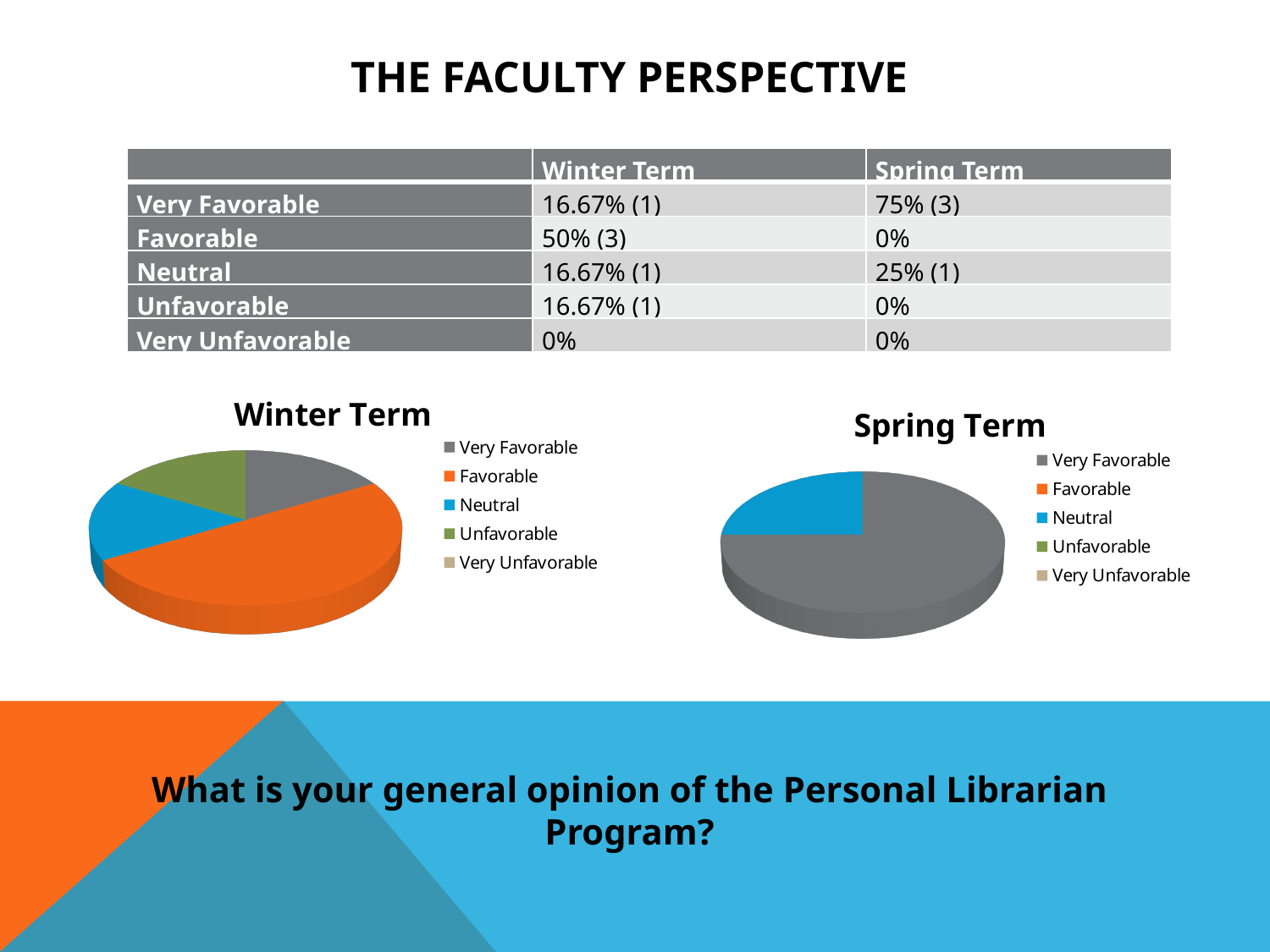
How many entries does the legend of the Spring Term chart list? 5 In the Spring Term chart, what share of the pie is Very Favorable? 75% In the Winter Term chart, what share of the pie is Favorable? 50% In the Spring Term chart, which category has the largest slice? Very Favorable What kind of chart is the Winter Term chart? pie chart In the Winter Term chart, is the Favorable slice larger or smaller than the Neutral slice? larger In the Spring Term chart, what share of the pie is Neutral? 25% In the Spring Term chart, how many categories have a visible slice? 2 What colour is the Favorable slice in the Winter Term chart? orange In the Winter Term chart, which category has the largest slice? Favorable What is the difference between the Very Favorable share in the Spring Term chart and the Neutral share in the Spring Term chart? 50%